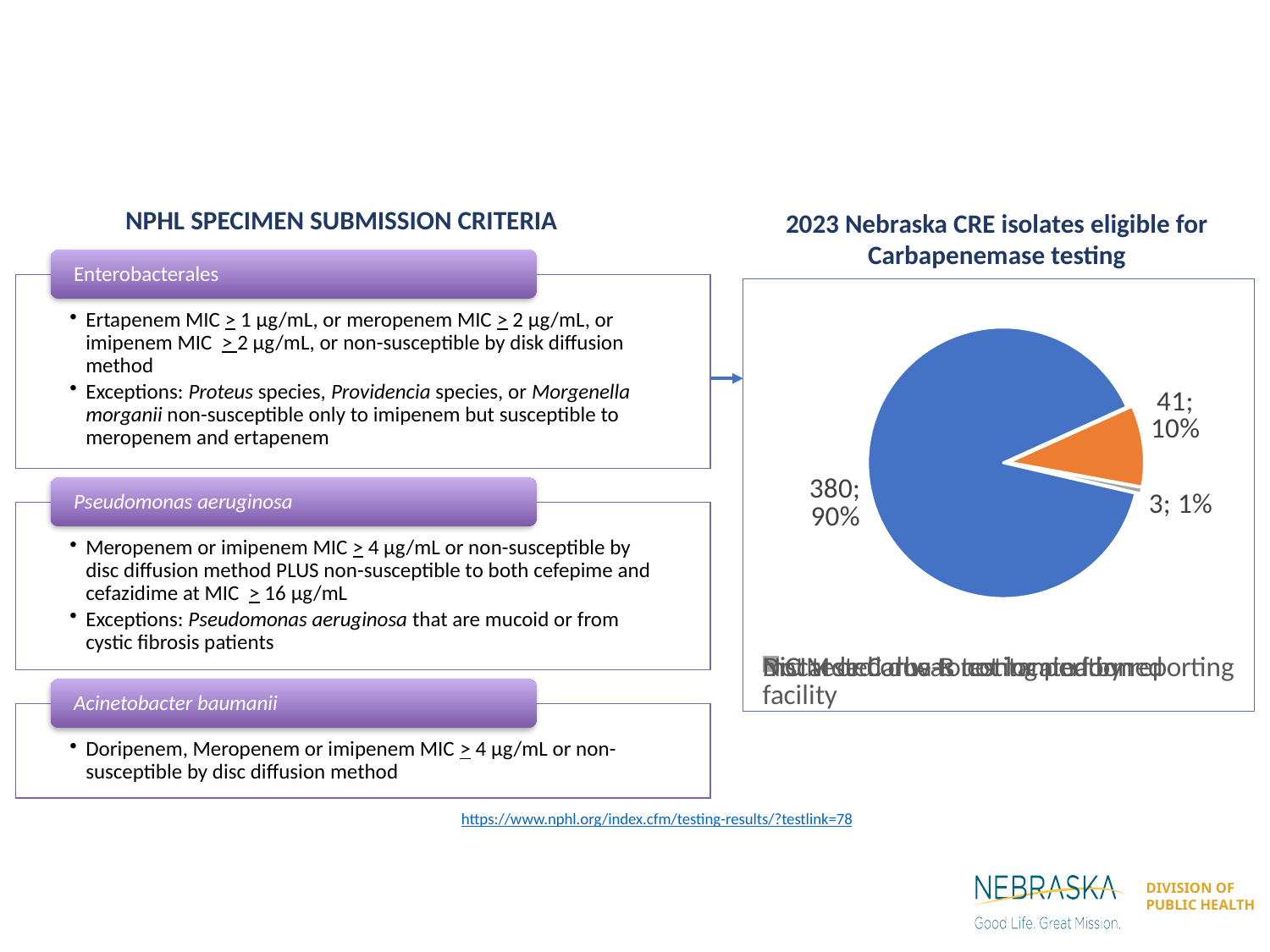
Which slice is larger, the orange slice or the grey slice? orange slice What share of the pie does the grey slice represent? 1% What is the value shown for the orange slice of the pie chart? 41 What is the value of the smallest slice of the pie chart? 3 What kind of chart is shown on the slide? pie chart What is the title of the chart on the slide? 2023 Nebraska CRE isolates eligible for Carbapenemase testing What is the value of the largest slice of the pie chart? 380 What share of the pie does the orange slice represent? 10% What share of the pie does the blue slice represent? 90% What is the total of all the values shown on the pie chart? 424 What is the difference between the values of the blue slice and the orange slice? 339 How many slices does the pie chart have? 3